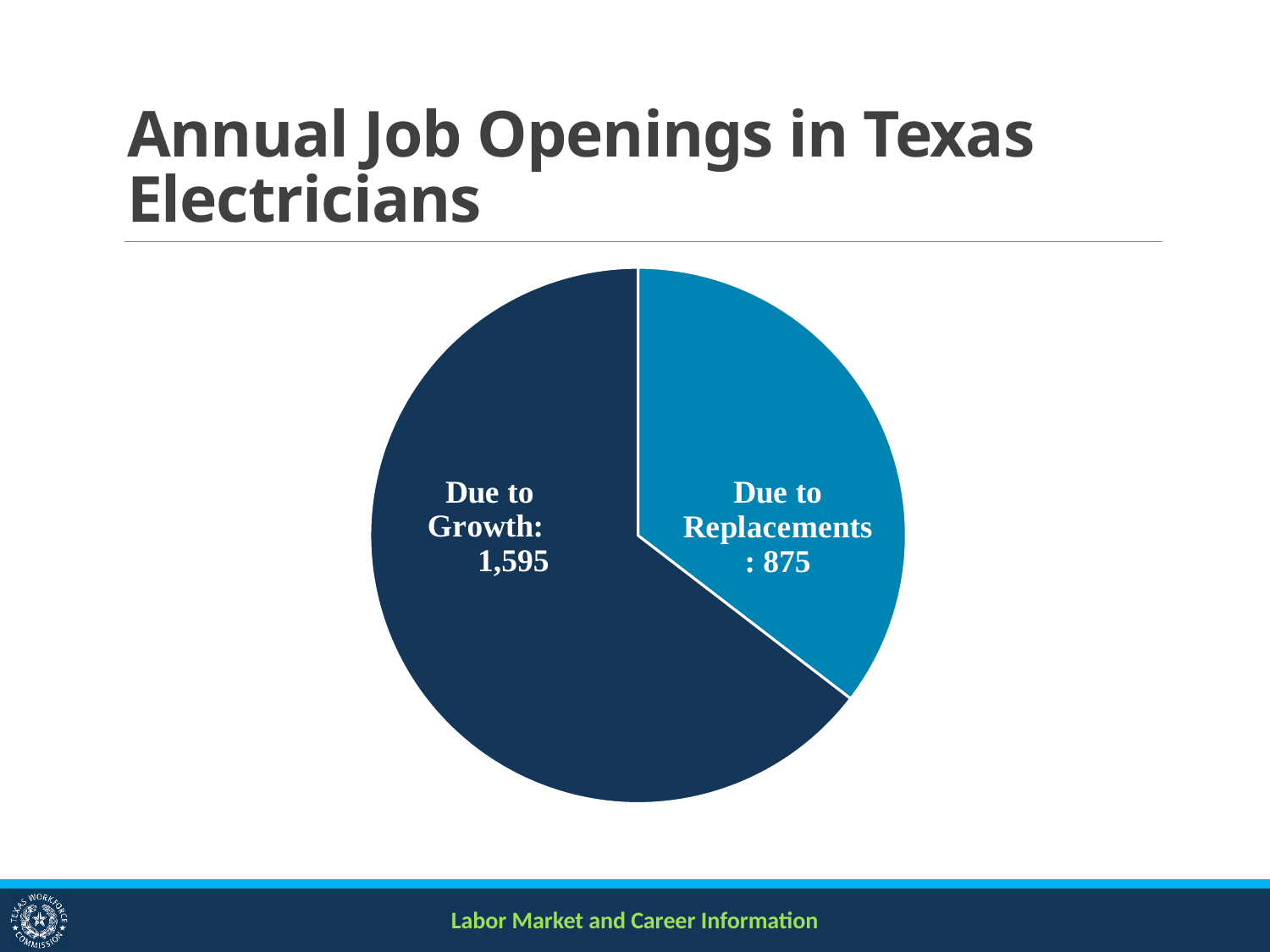
Which slice of the pie is the smallest? Due to Replacements What is the title of the slide containing the pie chart? Annual Job Openings in Texas Electricians How many slices does the pie chart have? 2 Which slice is shown in the lighter blue colour? Due to Replacements Which is larger: openings due to growth or openings due to replacements? Due to Growth Which slice of the pie is the largest? Due to Growth What is the difference between the openings due to growth and the openings due to replacements? 720 What is the total number of annual job openings shown in the pie chart? 2,470 How many annual job openings for electricians in Texas are due to replacements? 875 What share of the total annual job openings is due to growth? 64.6% What kind of chart is shown on the slide? Pie chart How many annual job openings for electricians in Texas are due to growth? 1,595